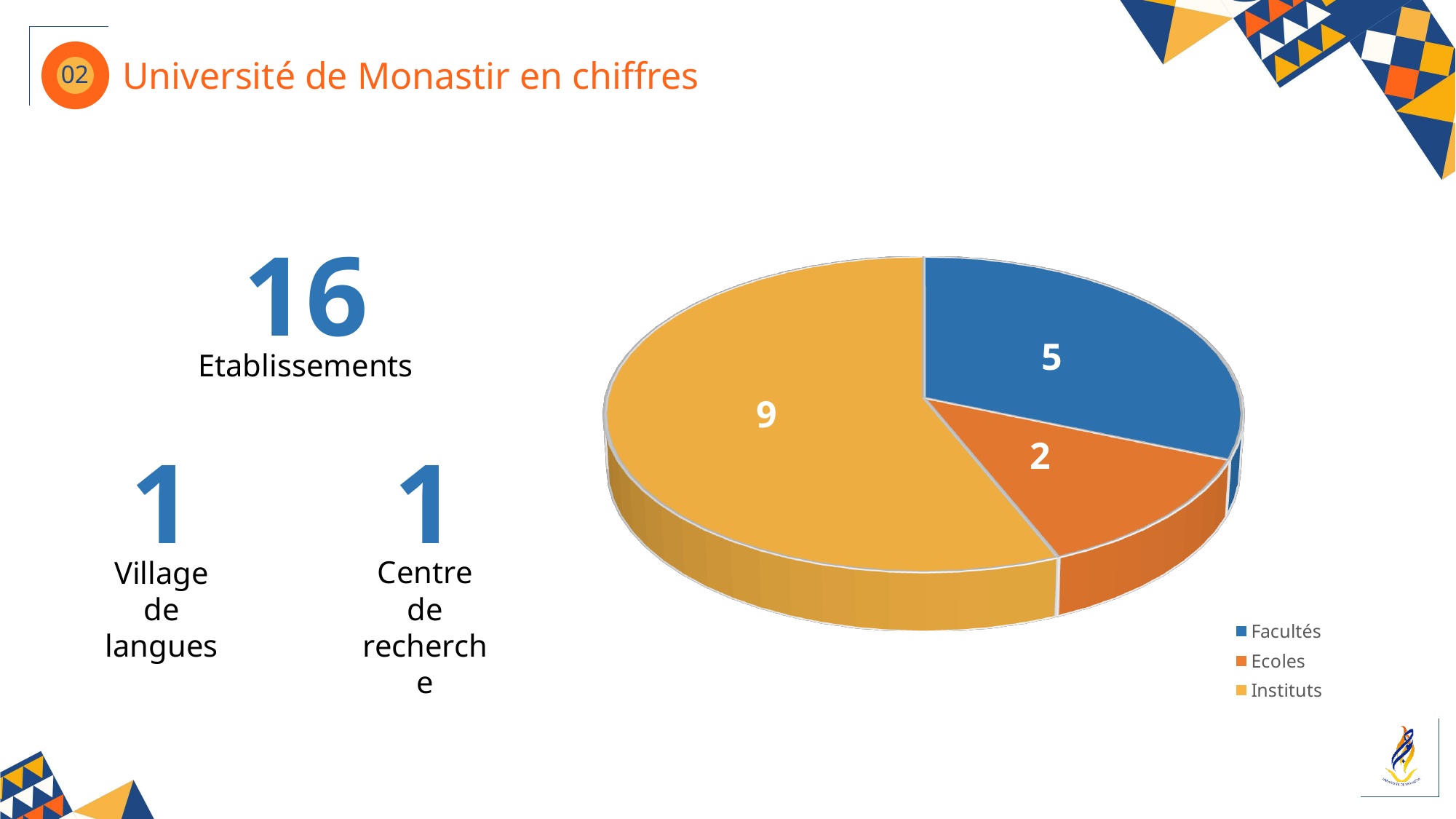
What is the value for Ecoles in the pie chart? 2 Which category has the largest slice in the pie chart? Instituts What is the value for Facultés in the pie chart? 5 What kind of chart is shown on the slide? pie chart Which is larger, the value for Facultés or the value for Ecoles? Facultés Which category has the smallest slice in the pie chart? Ecoles What is the value for Instituts in the pie chart? 9 How many slices does the pie chart have? 3 What is the difference between the values for Instituts and Facultés? 4 What is the total of all slices in the pie chart? 16 How many entries does the legend of the pie chart list? 3 Which colour represents Ecoles in the pie chart? orange